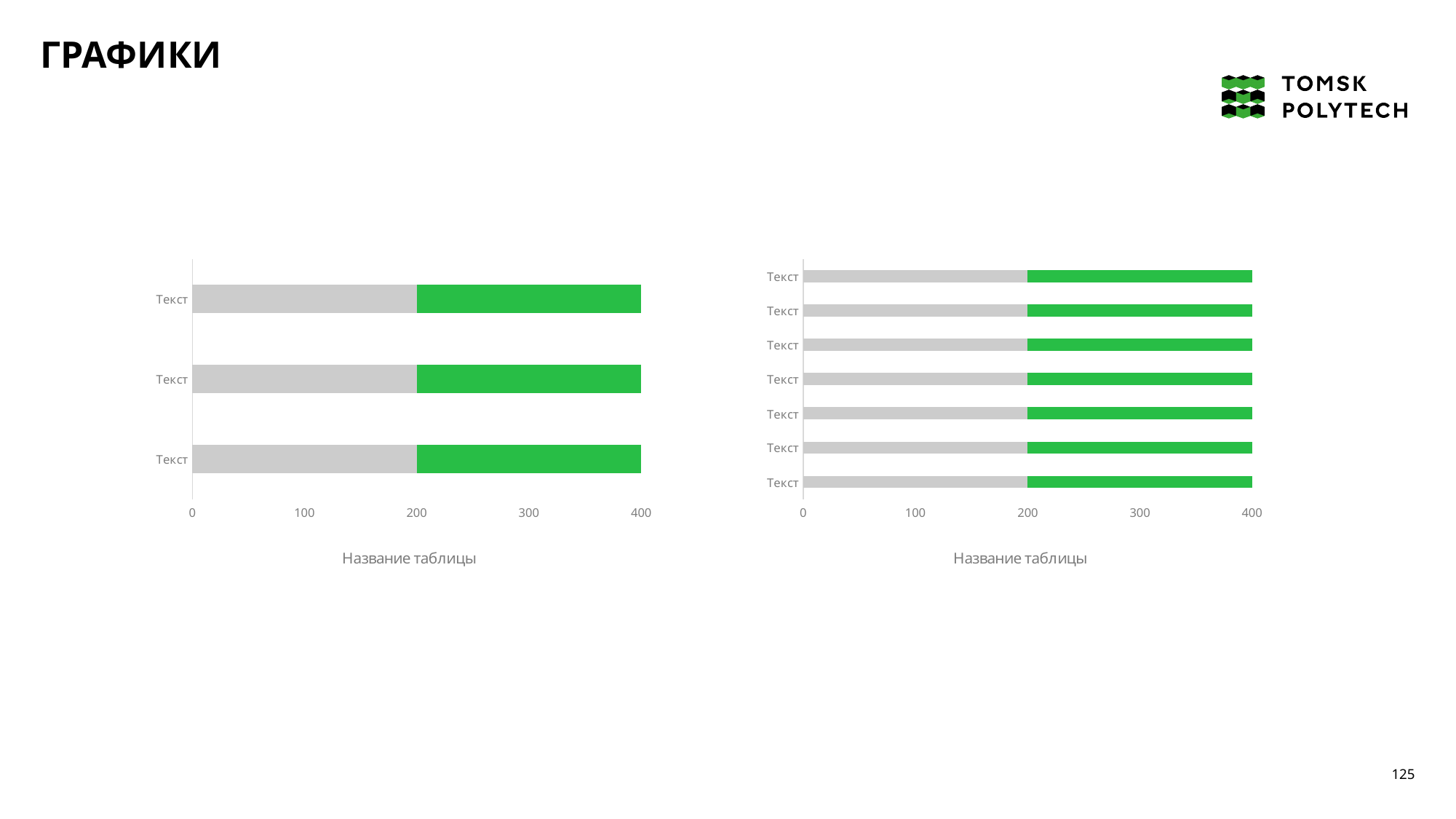
What kind of chart is the chart on the left side of the slide? bar chart What two colours are used for the bar segments in the chart on the right side of the slide? gray and green What is the title shown below the chart on the left side of the slide? Название таблицы In the chart on the left side of the slide, is the total of the bottom bar greater or less than 300? greater In the chart on the right side of the slide, is the gray segment of the top bar greater or less than 300? less In the chart on the left side of the slide, what is the total length of the top stacked bar according to the axis? 400 How many bars (categories) does the chart on the left side of the slide have? 3 How many bars (categories) does the chart on the right side of the slide have? 7 In the chart on the left side of the slide, at what axis value does the gray segment of the top bar end? 200 What kind of chart is the chart on the right side of the slide? bar chart In the chart on the right side of the slide, at what axis value does the gray segment of the top bar end? 200 In the chart on the right side of the slide, what is the total length of the bottom stacked bar according to the axis? 400